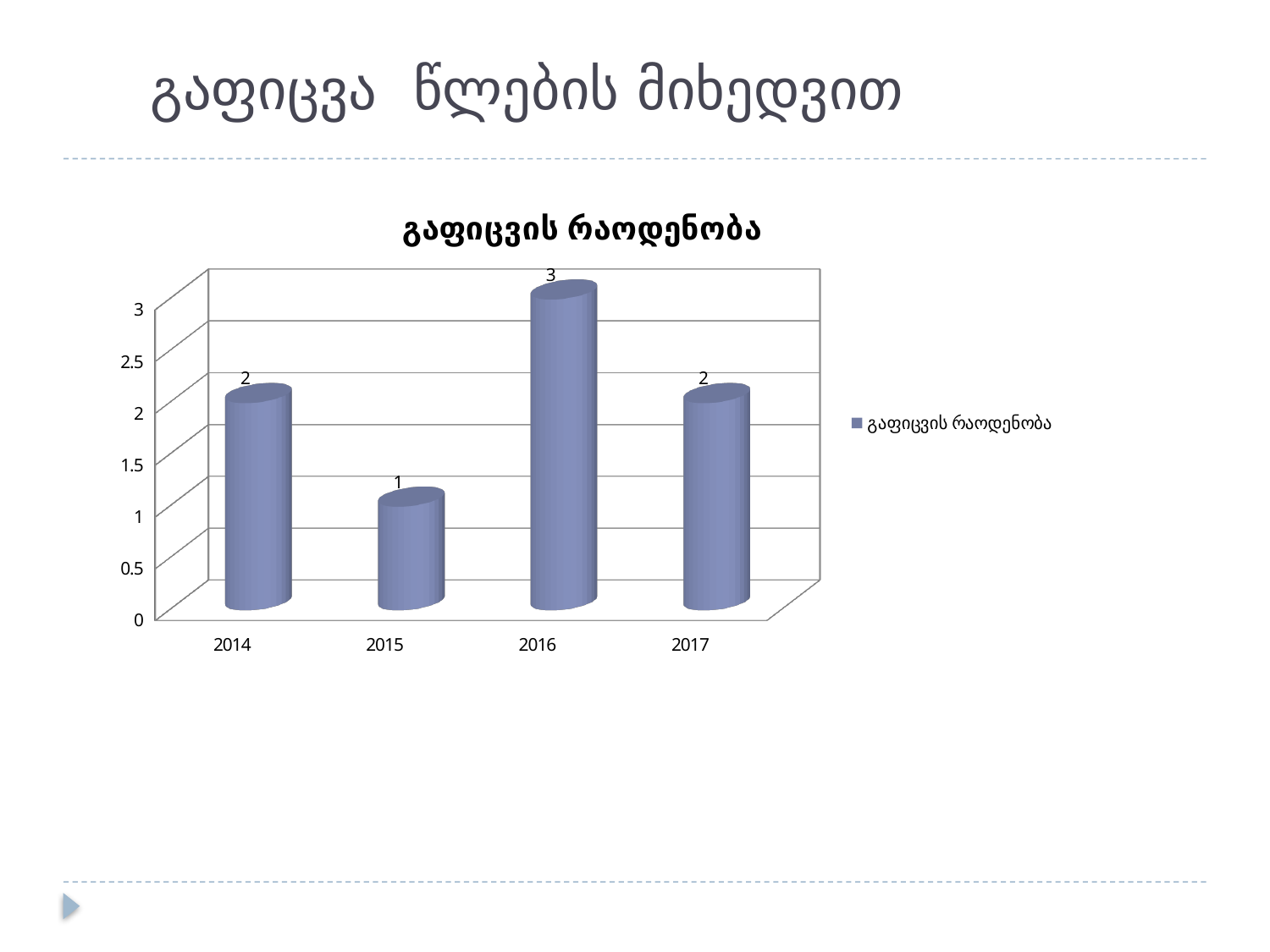
How many series does the legend list? 1 What is the value for 2014? 2 What is the difference between the values for 2016 and 2015? 2 Which year has the lowest value? 2015 What kind of chart is shown? bar chart What is the value for 2015? 1 What is the value for 2017? 2 What is the title of the chart? გაფიცვის რაოდენობა How many years are shown on the x axis? 4 Which is larger, the value for 2016 or the value for 2017? 2016 What is the value for 2016? 3 Which year has the highest value? 2016